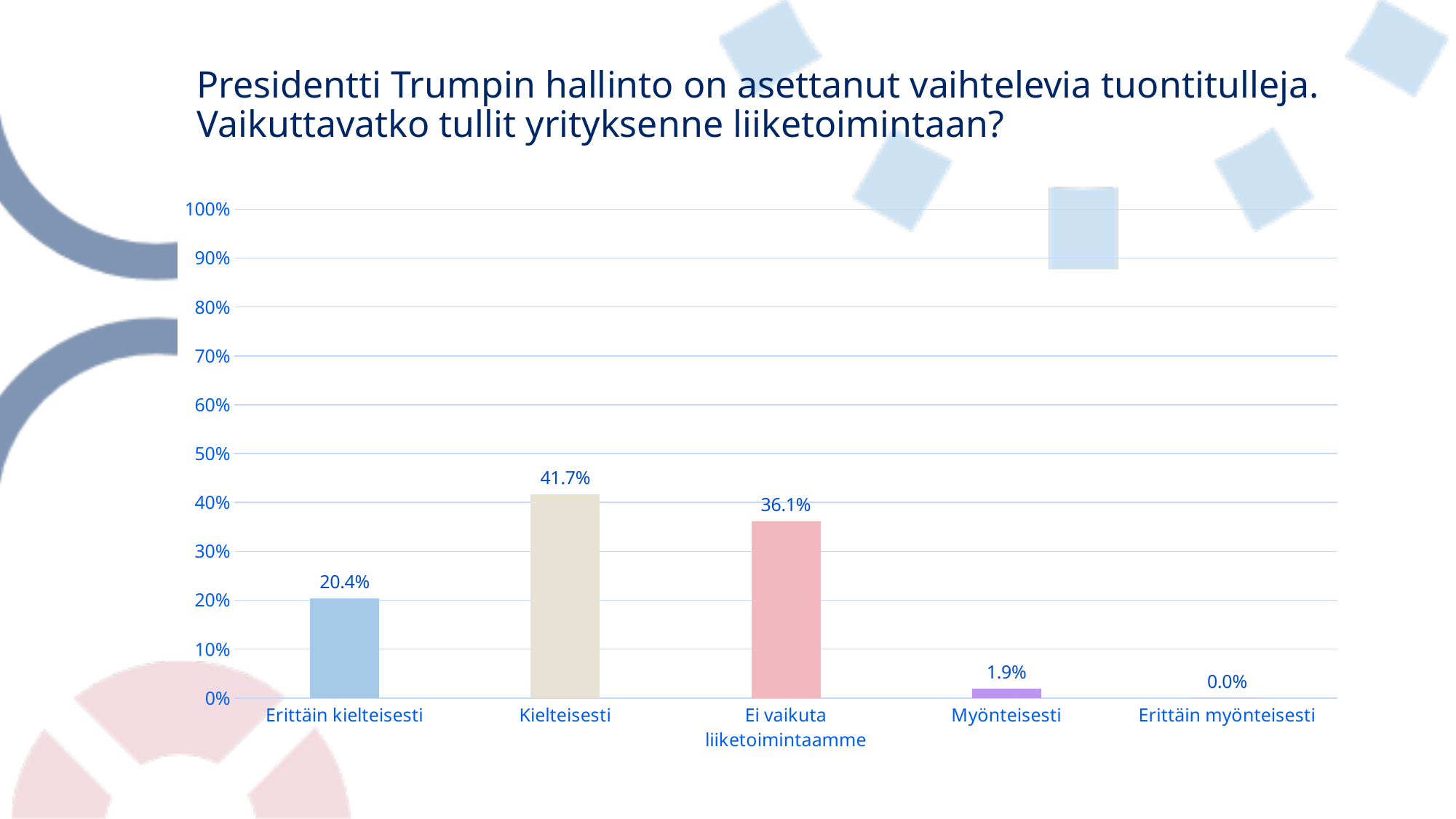
Which category has the lowest value? Erittäin myönteisesti What is the difference between the values for Kielteisesti and Ei vaikuta liiketoimintaamme? 5.6% What is the value for Myönteisesti? 1.9% Which is larger, the value for Erittäin kielteisesti or the value for Ei vaikuta liiketoimintaamme? Ei vaikuta liiketoimintaamme What is the value for Erittäin kielteisesti? 20.4% What kind of chart is shown on the slide? Bar chart How many categories are shown on the x axis? 5 What is the value for Ei vaikuta liiketoimintaamme? 36.1% What is the value for Erittäin myönteisesti? 0.0% What is the highest value shown on the y axis? 100% What is the value for Kielteisesti? 41.7% Which category has the highest value? Kielteisesti